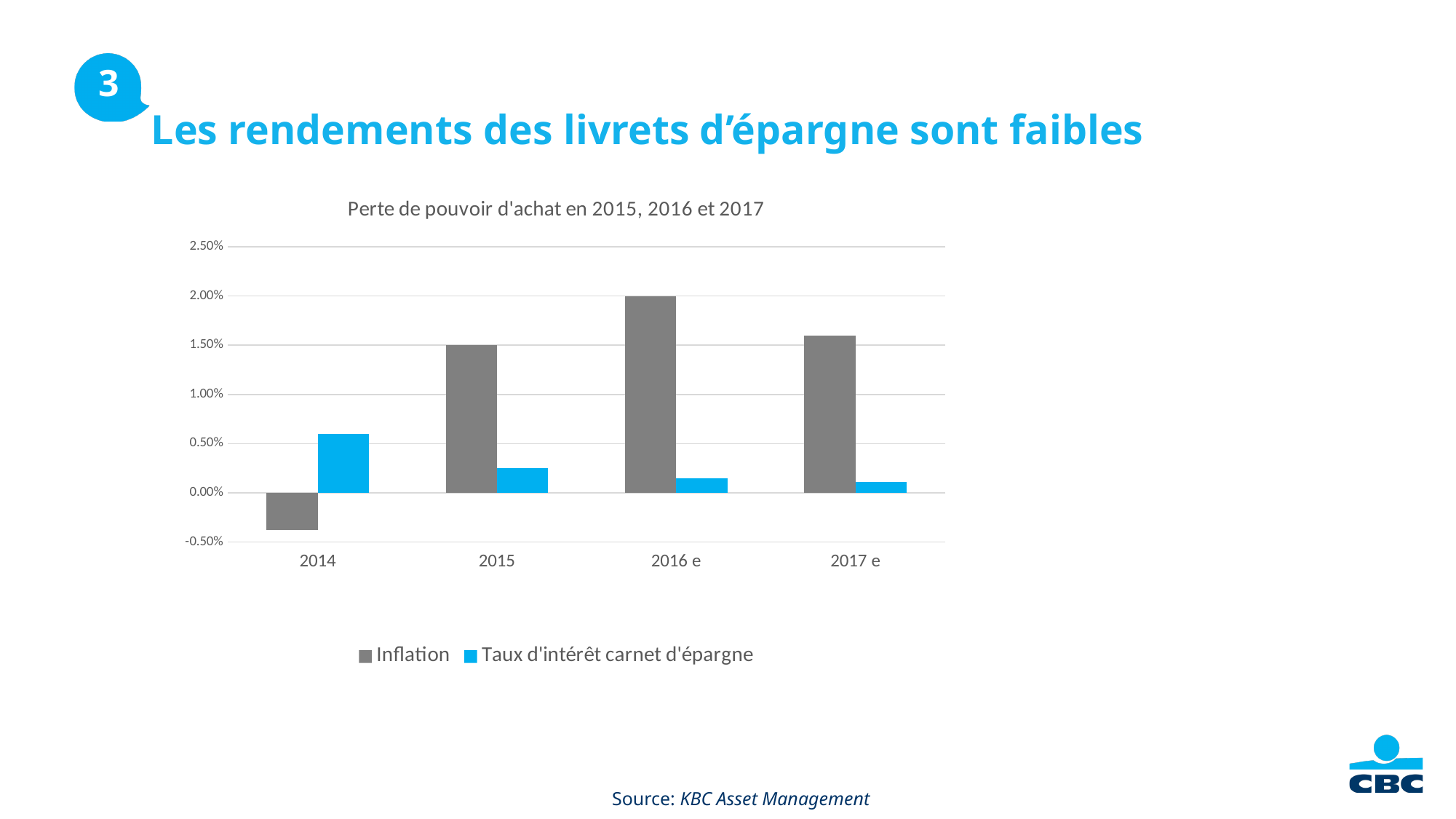
What is the Inflation value for 2016 e? 2.00% What is the difference between the Inflation value for 2016 e and for 2015? 0.50% What is the Inflation value for 2015? 1.50% Is the Taux d'intérêt carnet d'épargne value for 2014 greater or less than 0.50%? greater In which year is the Taux d'intérêt carnet d'épargne highest? 2014 How many series does the legend list? 2 Does the Taux d'intérêt carnet d'épargne rise or fall from 2014 to 2017 e? Fall How many year categories are shown on the x axis? 4 What kind of chart is shown on the slide? Bar chart Is the Inflation value for 2014 greater or less than 0.00%? less In which year is Inflation highest? 2016 e In which year is Inflation lowest? 2014